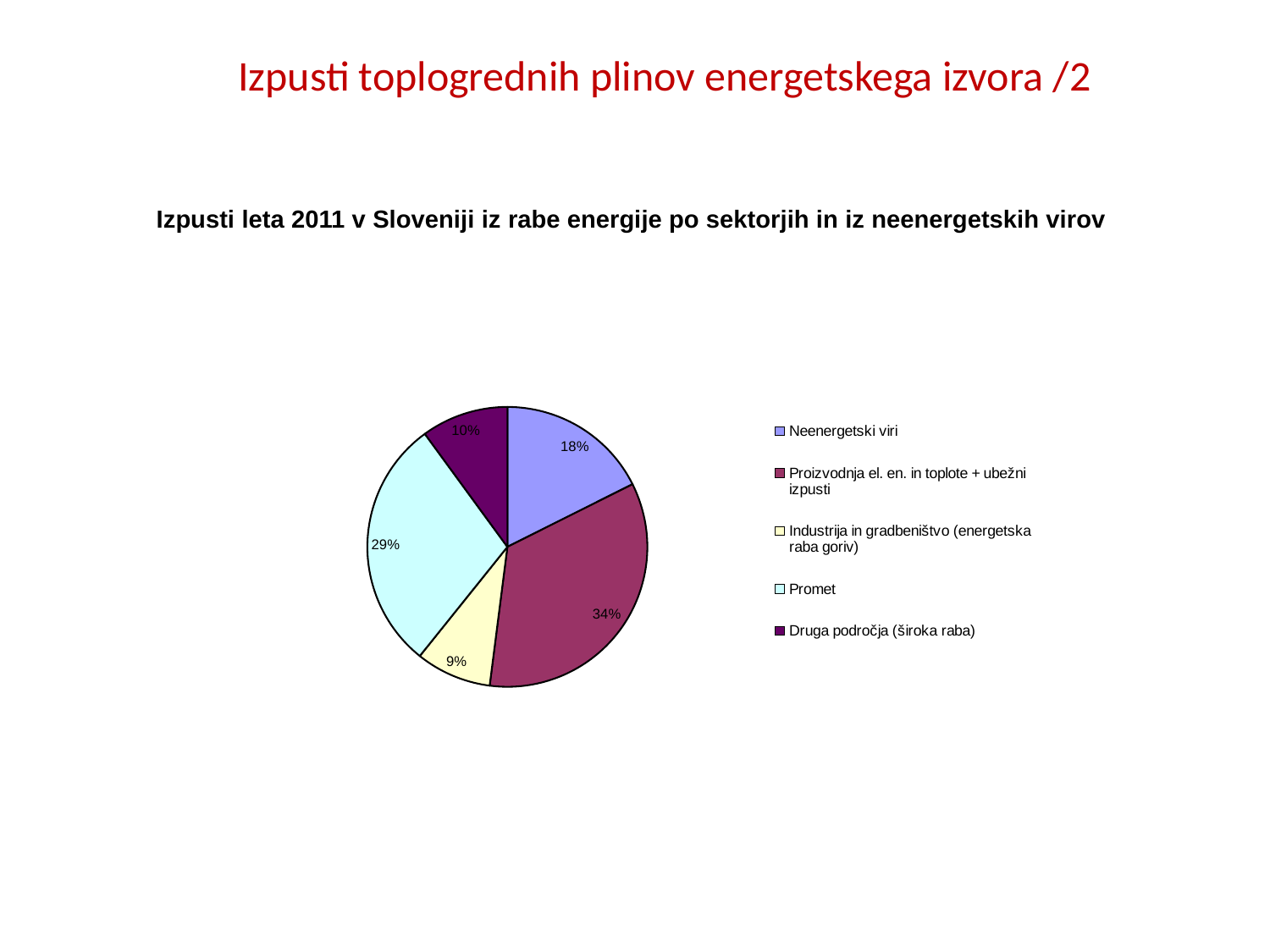
What is the title of the chart? Izpusti leta 2011 v Sloveniji iz rabe energije po sektorjih in iz neenergetskih virov Which category has the largest share of the pie? Proizvodnja el. en. in toplote + ubežni izpusti What type of chart is shown on the slide? pie chart What share of the pie does Proizvodnja el. en. in toplote + ubežni izpusti represent? 34% What is the difference in percentage points between the shares of Proizvodnja el. en. in toplote + ubežni izpusti and Promet? 5 What share of the pie does Neenergetski viri represent? 18% What share of the pie does Promet represent? 29% Which category has the smallest share of the pie? Industrija in gradbeništvo (energetska raba goriv) How many categories are shown in the pie chart? 5 Which has a larger share, Neenergetski viri or Druga področja (široka raba)? Neenergetski viri